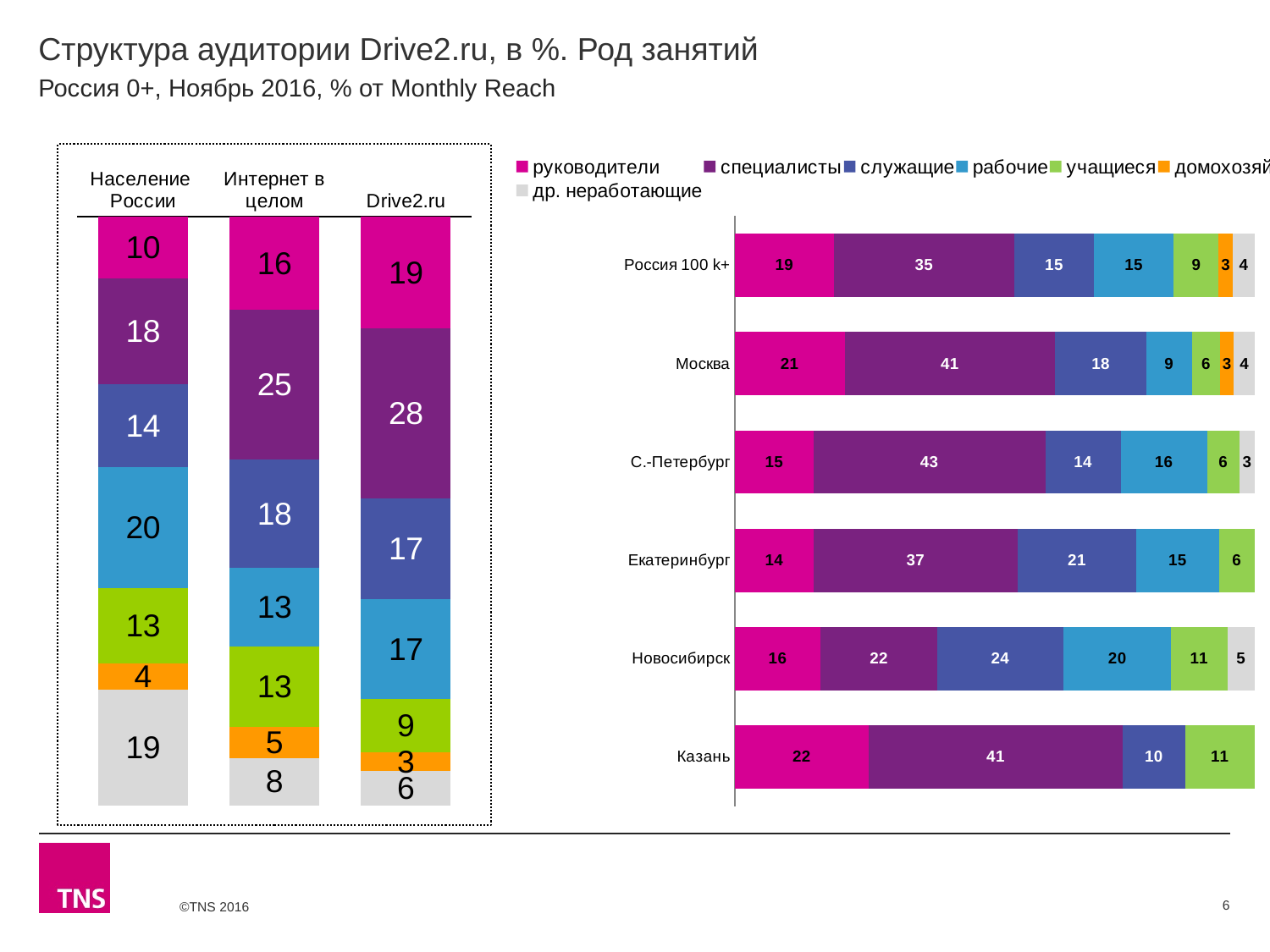
In the left chart, how many bars (categories) are shown? 3 In the left chart, what is the value for специалисты in the Drive2.ru bar? 28 What type of chart is the right chart? Stacked bar chart In the left chart, what is the difference between the руководители values for Drive2.ru and Население России? 9 In the right chart, how many cities/regions are listed on the vertical axis? 6 In the right chart, which city has the highest руководители value? Казань In the left chart, what is the value for рабочие in the Население России bar? 20 In the right chart, which is larger: the рабочие value for Москва or for Екатеринбург? Екатеринбург In the left chart, what is the value for др. неработающие in the Интернет в целом bar? 8 In the left chart, which bar has the largest специалисты segment? Drive2.ru In the right chart, what is the value for специалисты for С.-Петербург? 43 In the right chart, what is the value for служащие for Новосибирск? 24